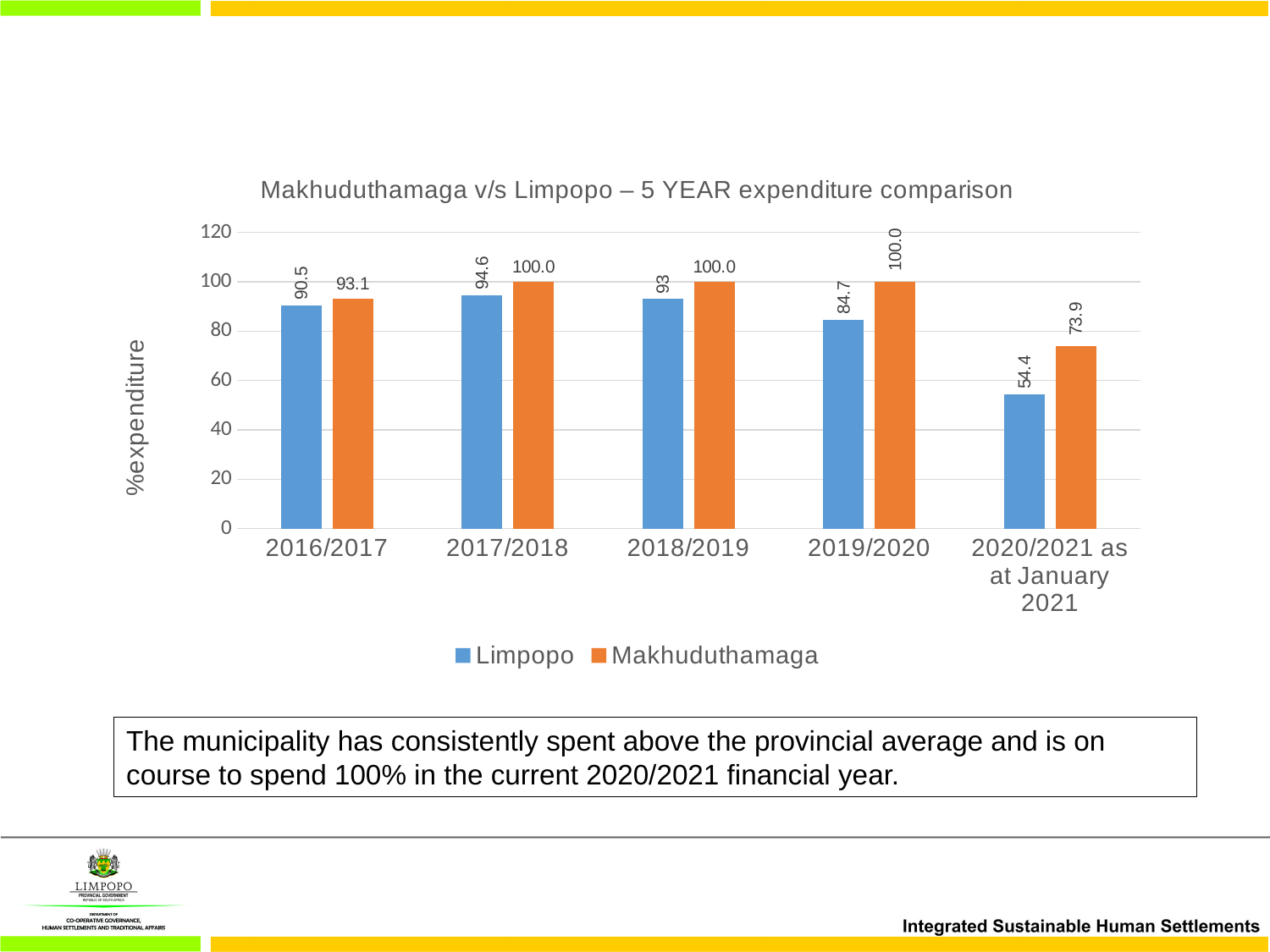
What is the difference between the Makhuduthamaga and Limpopo values for 2019/2020? 15.3 What is the Limpopo value for 2016/2017? 90.5 What is the title of the chart? Makhuduthamaga v/s Limpopo – 5 YEAR expenditure comparison Which year has the highest Limpopo value? 2017/2018 Which is larger in 2016/2017, the Limpopo value or the Makhuduthamaga value? Makhuduthamaga What is the Makhuduthamaga value for 2020/2021 as at January 2021? 73.9 How many series does the legend list? 2 What kind of chart is shown on the slide? bar chart Which year has the lowest Limpopo value? 2020/2021 as at January 2021 Is the Limpopo value for 2020/2021 as at January 2021 greater or less than 60? less How many financial years are shown on the x axis? 5 What is the Limpopo value for 2019/2020? 84.7